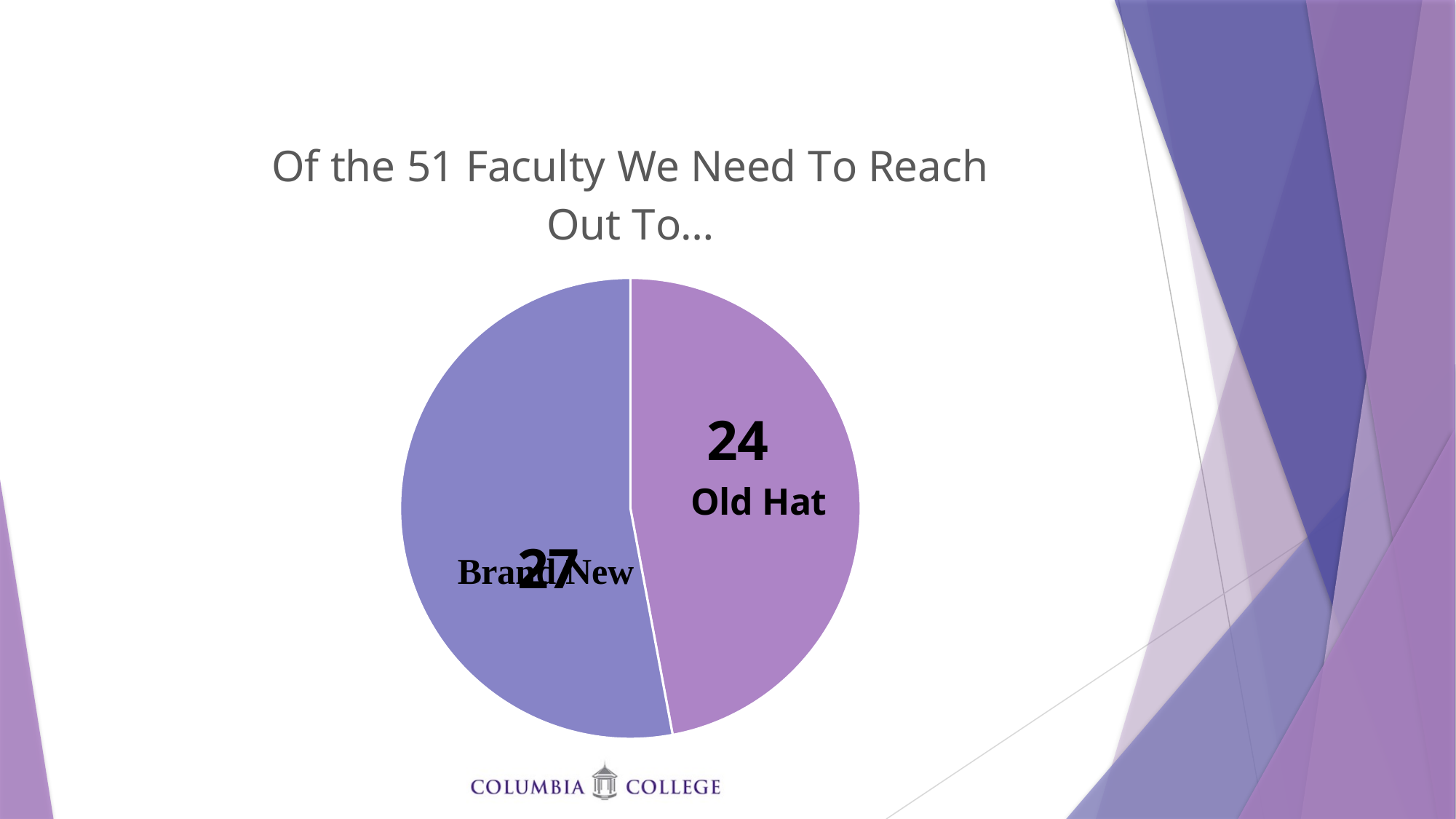
Which slice of the pie chart is the largest? Brand New How many faculty are labelled "Brand New" in the pie chart? 27 What colour is the Old Hat slice of the pie chart? purple Which slice of the pie chart is the smallest? Old Hat What is the difference between the Brand New and Old Hat values in the pie chart? 3 Which is larger in the pie chart, Old Hat or Brand New? Brand New How many faculty are labelled "Old Hat" in the pie chart? 24 How many slices does the pie chart have? 2 What type of chart is shown on the slide? pie chart What is the title of the chart on the slide? Of the 51 Faculty We Need To Reach Out To... What is the total of the two slices in the pie chart? 51